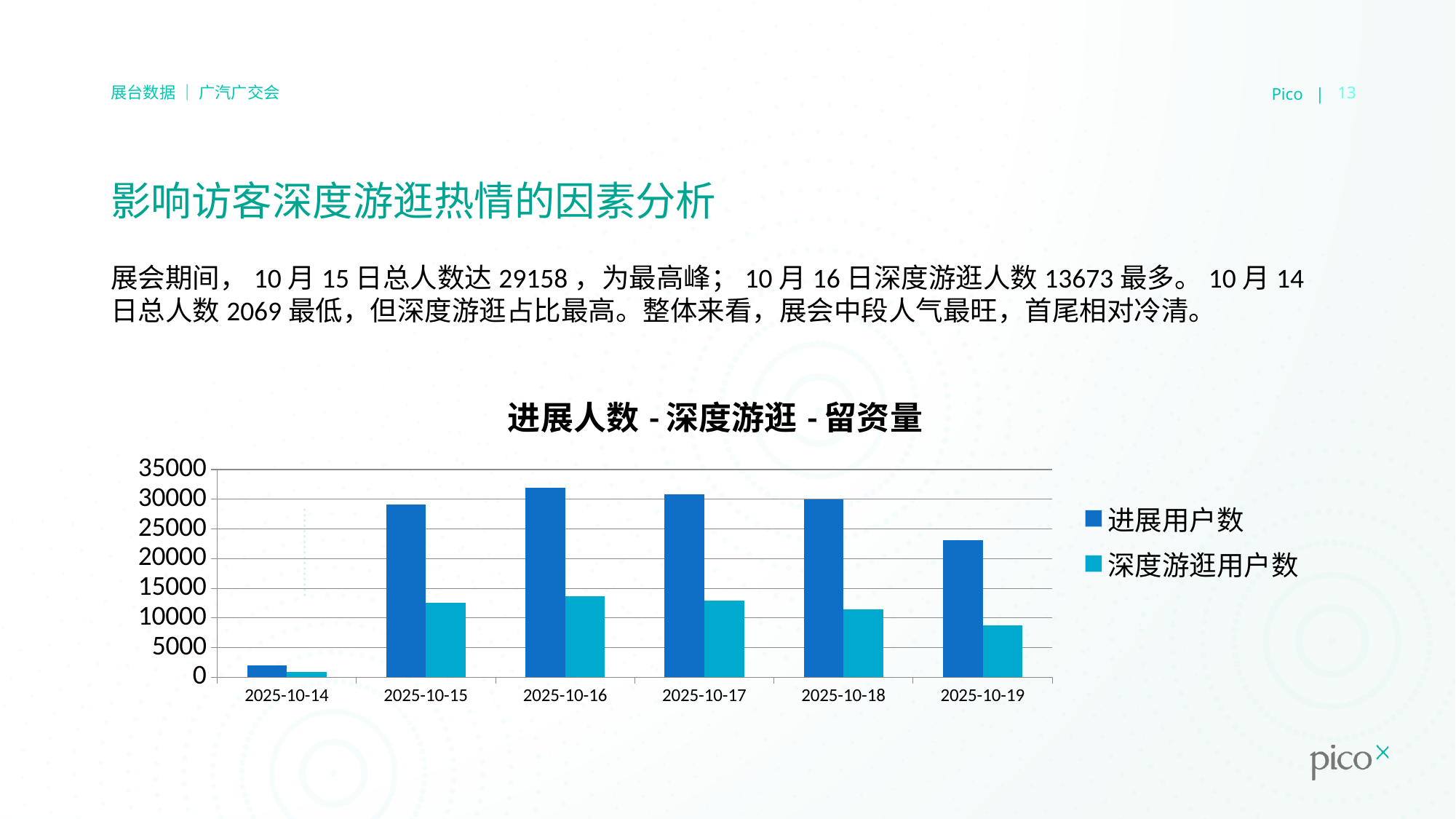
How many dates are shown on the x axis of the chart? 6 On which date is the 深度游逛用户数 bar the shortest? 2025-10-14 Is the 进展用户数 value for 2025-10-14 greater or less than 5000? less On which date is the 进展用户数 bar the shortest? 2025-10-14 What kind of chart is shown on the slide? Bar chart Do the 进展用户数 values rise or fall from 2025-10-16 to 2025-10-19? fall How many series does the chart legend list? 2 Is the 进展用户数 value for 2025-10-19 greater or less than 20000? greater Which is larger, the 进展用户数 value for 2025-10-15 or for 2025-10-19? 2025-10-15 What is the title of the chart? 进展人数 - 深度游逛 - 留资量 On which date is the 进展用户数 bar the tallest? 2025-10-16 Is the 深度游逛用户数 value for 2025-10-19 greater or less than 10000? less